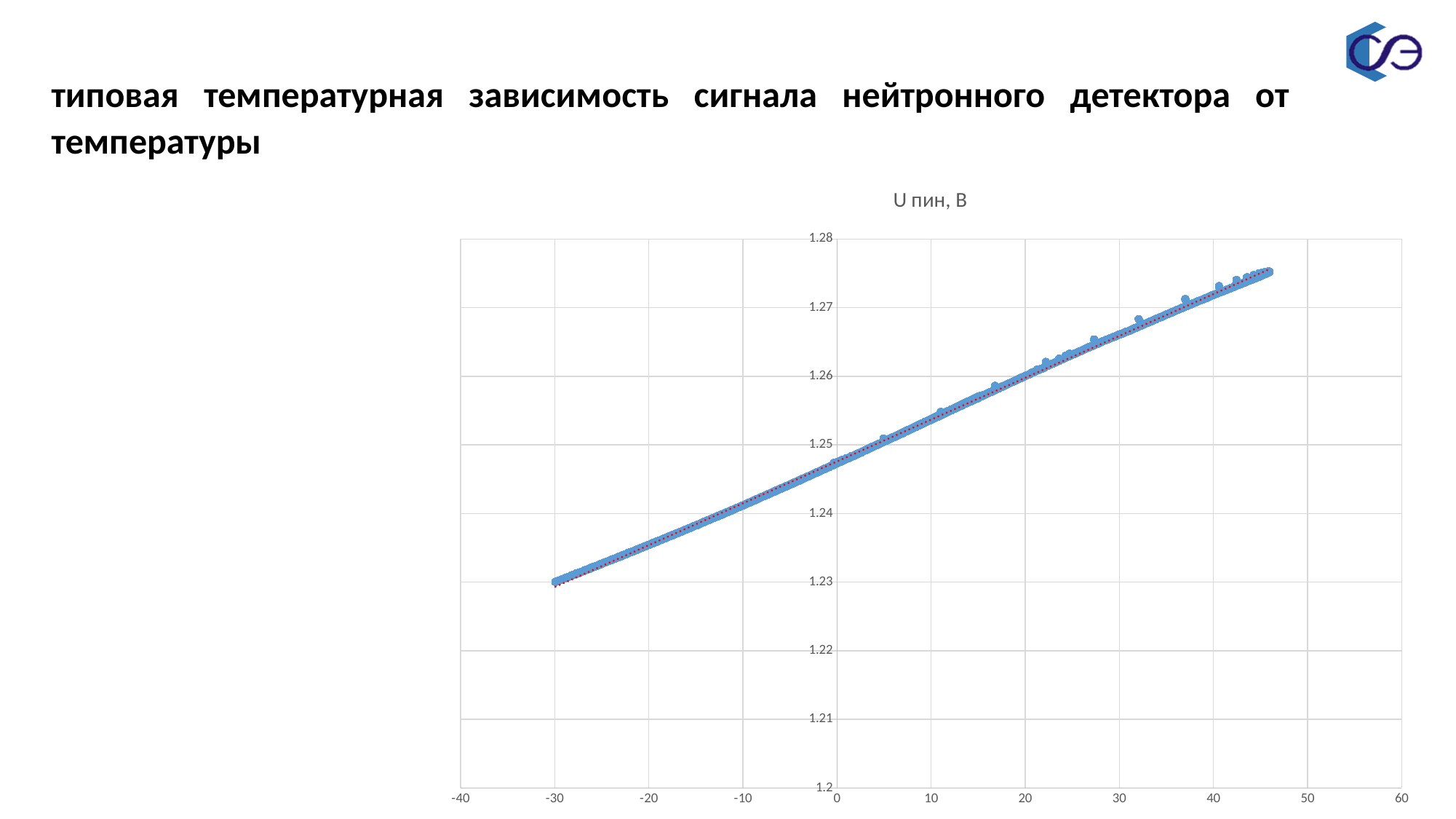
What is the title of the chart? U пин, В What kind of chart is shown on the slide? scatter chart Is the value at x = 30 greater or less than 1.26? greater Do the plotted values rise or fall as the x-axis value increases? rise What colour is the dotted trend line drawn through the data points? red Is the value at x = -20 greater or less than 1.24? less Is the value at x = -20 greater or less than 1.23? greater